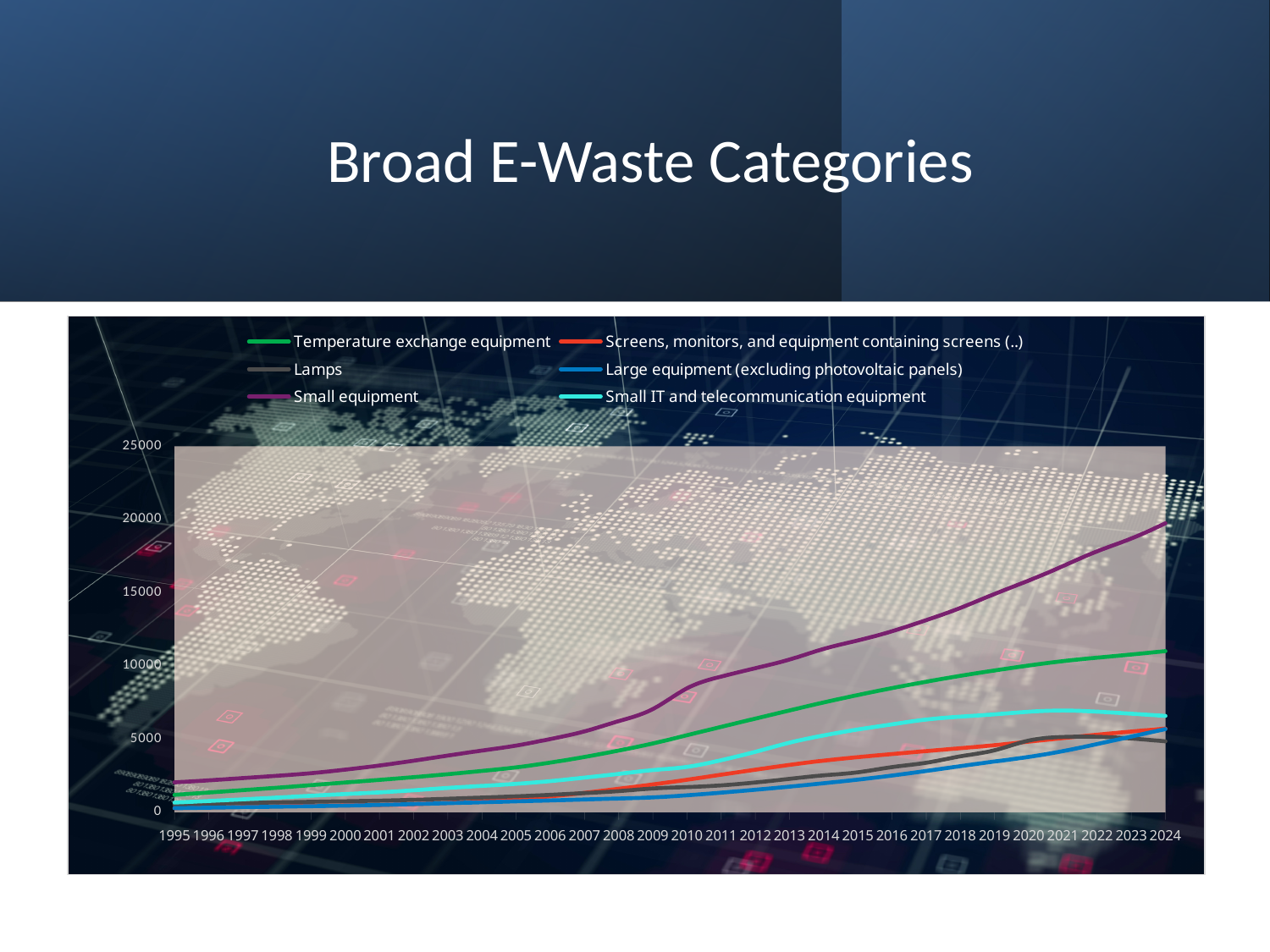
How many series does the legend list? 6 How many years are shown along the x axis? 30 Is the value for Temperature exchange equipment in 2024 greater or less than 15000? less Is the value for Lamps in 2010 greater or less than 5000? less Does the Small equipment series rise or fall from 1995 to 2024? rise Is the value for Small equipment in 2024 greater or less than 15000? greater Which series has the highest value in 2024? Small equipment What kind of chart is shown on the slide? line chart Which series has the lowest value in 2024? Lamps In 2024, which is larger: Temperature exchange equipment or Small IT and telecommunication equipment? Temperature exchange equipment What is the title of the slide? Broad E-Waste Categories